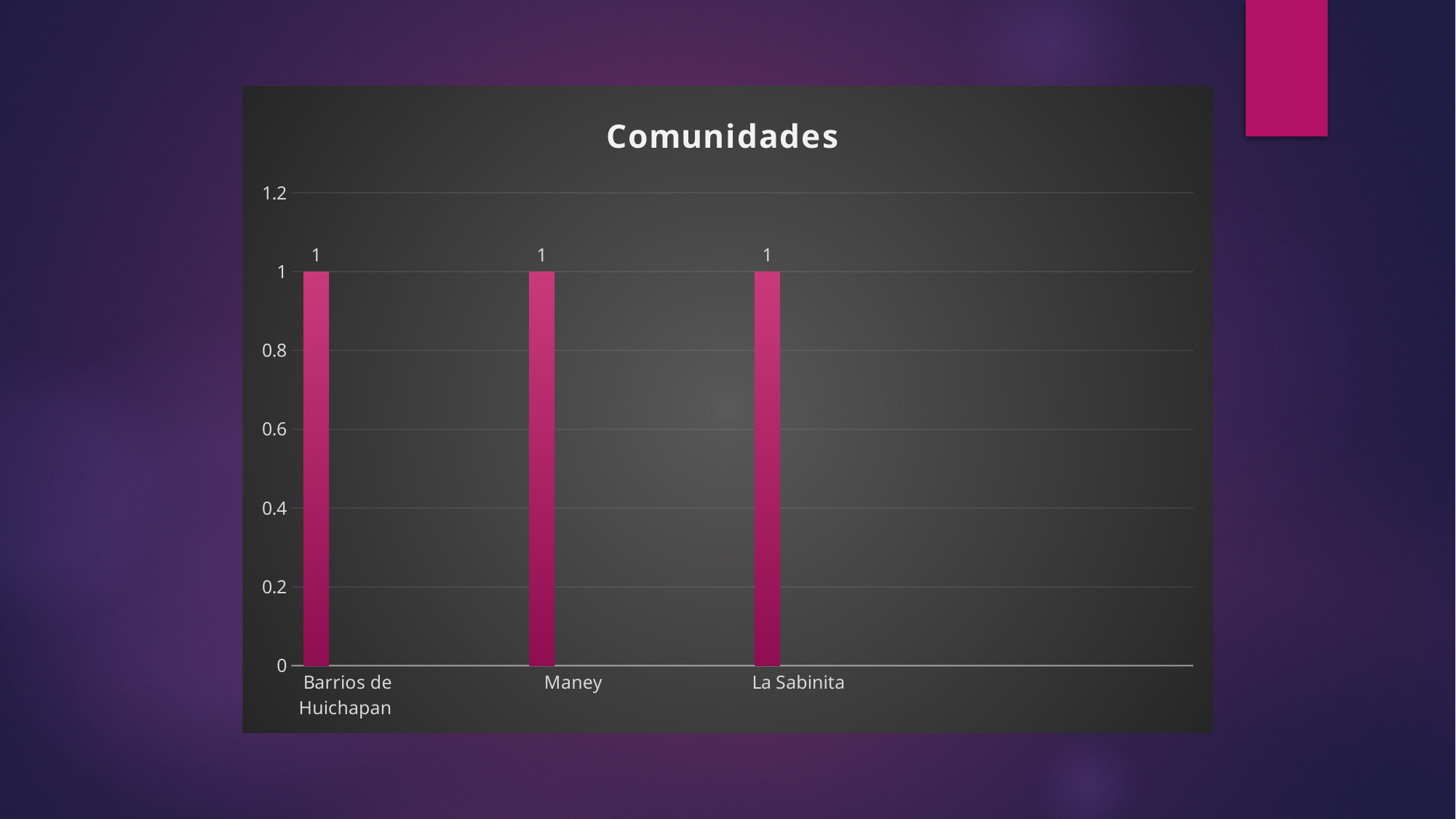
What is the title of the chart? Comunidades How many categories are shown on the x axis? 3 What is the total of the values for all three categories? 3 What is the value for Barrios de Huichapan? 1 Is the value for Maney greater or less than 1.2? less What colour are the bars? pink/magenta Is the value for La Sabinita greater or less than 0.8? greater What is the value for La Sabinita? 1 Do the values rise, fall, or stay the same across the categories from left to right? stay the same What is the value for Maney? 1 What kind of chart is this? bar chart What is the difference between the values for Maney and La Sabinita? 0